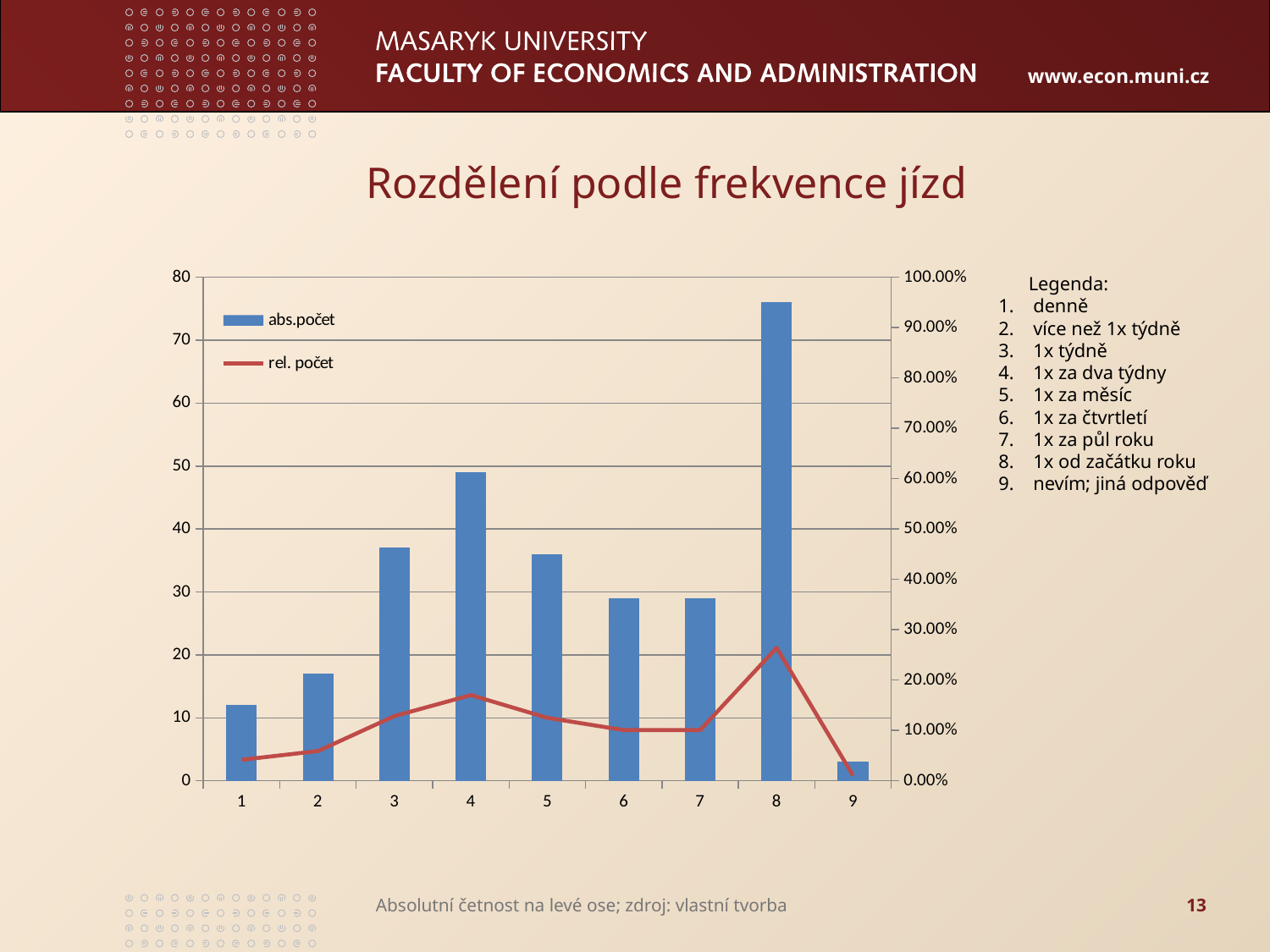
Which category has a larger abs.počet value, 1 or 2? 2 Which series in the chart is drawn as a line rather than bars? rel. počet Is the abs.počet value for category 4 greater or less than 40? greater How many categories are shown on the x axis of the chart? 9 Which category has a larger abs.počet value, 3 or 4? 4 What is the title of the chart? Rozdělení podle frekvence jízd How many series does the chart legend list? 2 Which category has the lowest abs.počet bar? 9 Is the abs.počet value for category 2 greater or less than 20? less Is the abs.počet value for category 8 greater or less than 70? greater Which category has the highest abs.počet bar? 8